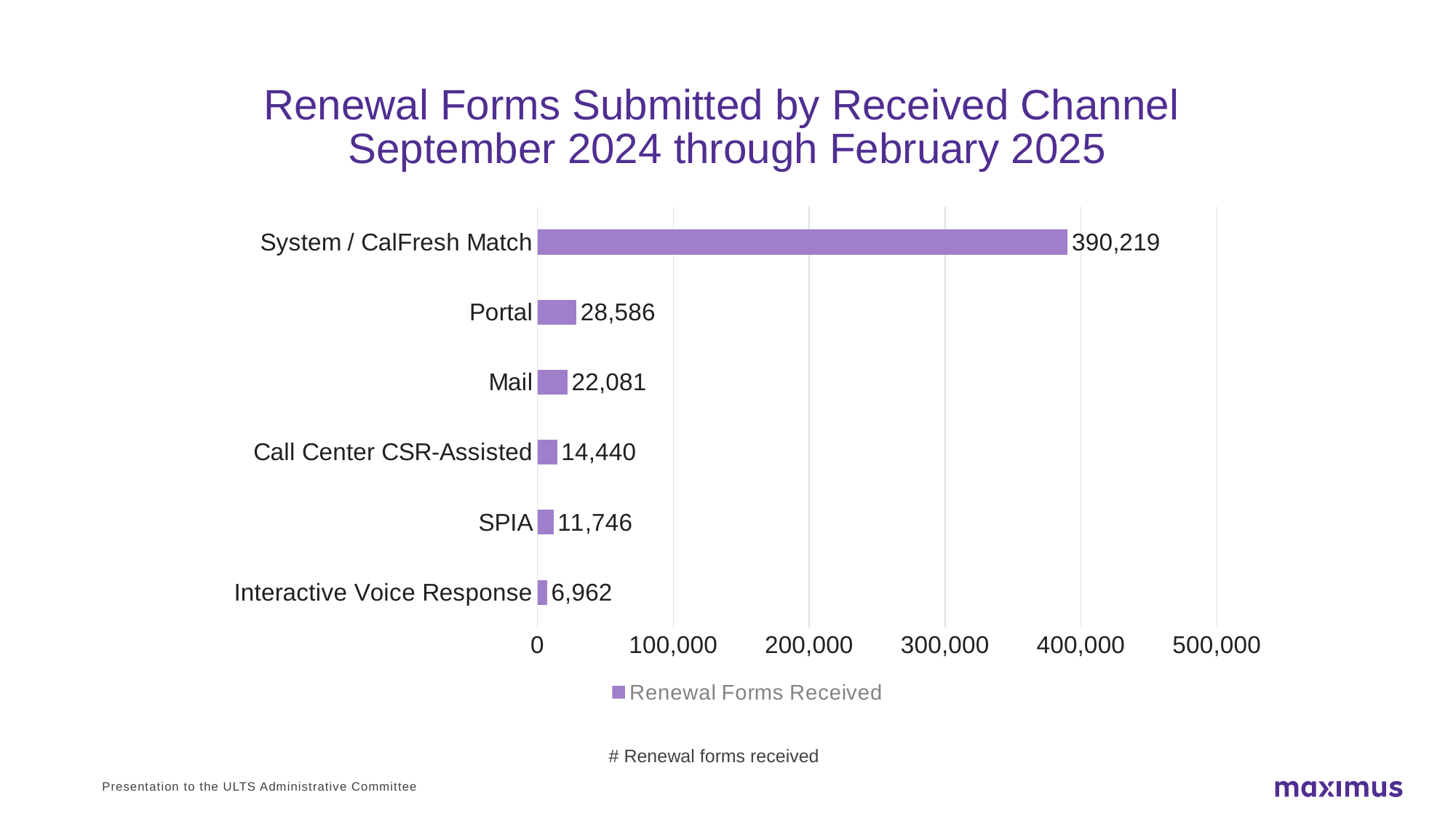
How many renewal forms were received via Interactive Voice Response? 6,962 Which channel has the lowest number of renewal forms received? Interactive Voice Response How many renewal forms were received through the Portal channel? 28,586 What type of chart is shown on the slide? bar chart Is the value for System / CalFresh Match greater or less than 300,000? greater What is the value for Mail? 22,081 How many channels are shown in the chart? 6 What is the difference between Call Center CSR-Assisted and SPIA? 2,694 Which channel has the highest number of renewal forms received? System / CalFresh Match What is the difference between the Portal and Mail values? 6,505 Which is larger, the value for Mail or the value for Call Center CSR-Assisted? Mail What is the legend entry shown below the chart? Renewal Forms Received